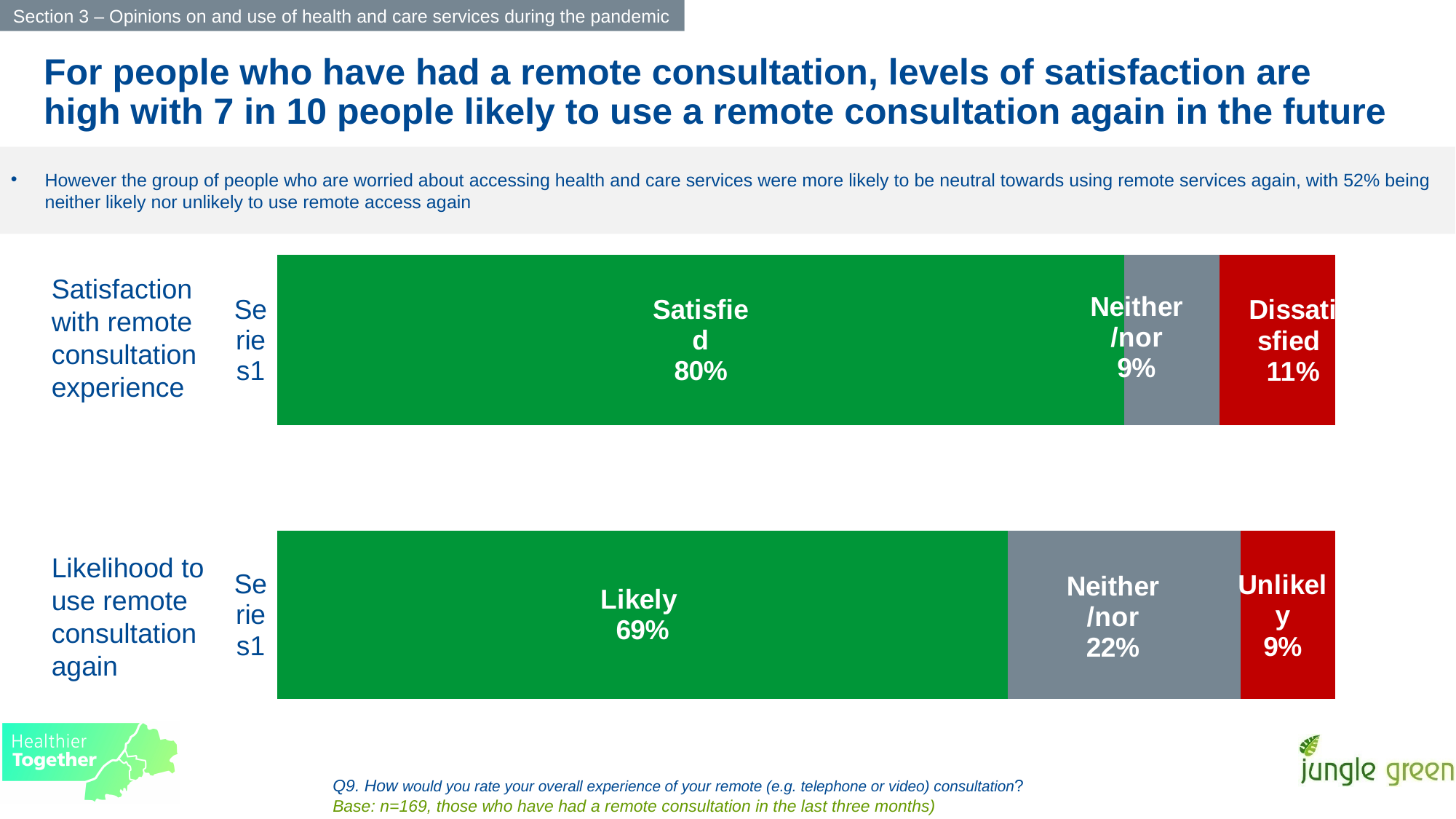
In the 'Likelihood to use remote consultation again' chart, what percentage answered Neither/nor? 22% In the 'Likelihood to use remote consultation again' chart, which segment is the smallest? Unlikely In the 'Satisfaction with remote consultation experience' chart, what percentage answered Neither/nor? 9% In the 'Likelihood to use remote consultation again' chart, which is larger: Neither/nor or Unlikely? Neither/nor In the 'Likelihood to use remote consultation again' chart, what percentage said Unlikely? 9% In the 'Likelihood to use remote consultation again' chart, what percentage said Likely? 69% In the 'Satisfaction with remote consultation experience' chart, what is the difference between the Satisfied and Dissatisfied percentages? 69% In the 'Satisfaction with remote consultation experience' chart, what colour is the Dissatisfied segment? Red In the 'Satisfaction with remote consultation experience' chart, what percentage were Satisfied? 80% In the 'Satisfaction with remote consultation experience' chart, what percentage were Dissatisfied? 11% What type of chart is used for 'Likelihood to use remote consultation again'? Stacked bar chart In the 'Satisfaction with remote consultation experience' chart, which segment is the largest? Satisfied